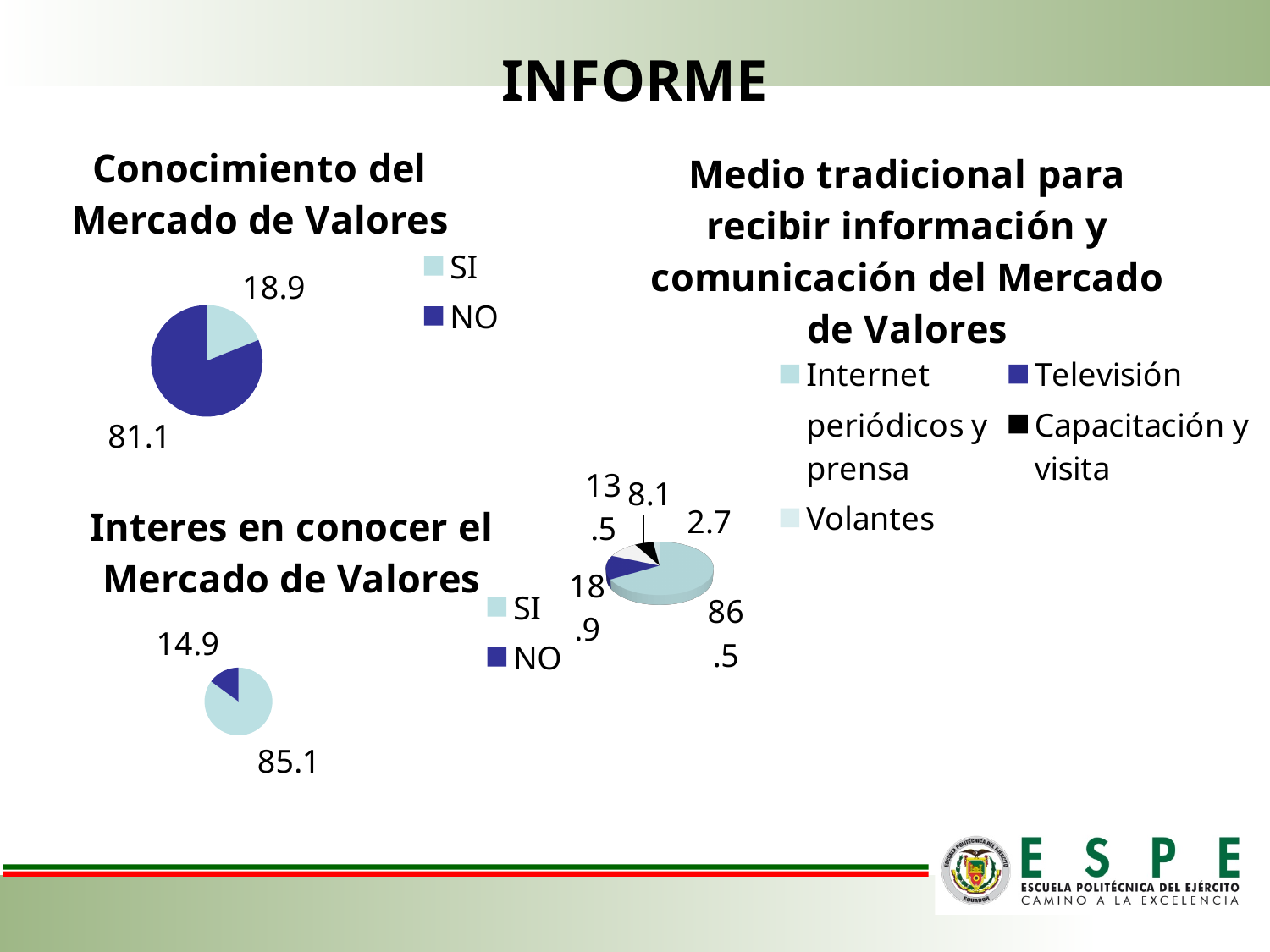
In the 'Conocimiento del Mercado de Valores' chart, what is the difference between NO and SI? 62.2 How many categories does the legend of the 'Medio tradicional para recibir información y comunicación del Mercado de Valores' chart list? 5 In the 'Conocimiento del Mercado de Valores' chart, what colour is the NO slice? Dark blue In the 'Conocimiento del Mercado de Valores' chart, what is the value for NO? 81.1 In the 'Interes en conocer el Mercado de Valores' chart, what is the value for SI? 85.1 In the 'Conocimiento del Mercado de Valores' chart, which category has the largest slice? NO In the 'Conocimiento del Mercado de Valores' chart, what is the value for SI? 18.9 How many categories does the 'Interes en conocer el Mercado de Valores' chart have? 2 In the 'Interes en conocer el Mercado de Valores' chart, what is the value for NO? 14.9 What kind of chart is 'Conocimiento del Mercado de Valores'? Pie chart In the 'Interes en conocer el Mercado de Valores' chart, which is larger, SI or NO? SI In the 'Interes en conocer el Mercado de Valores' chart, which category has the smallest slice? NO